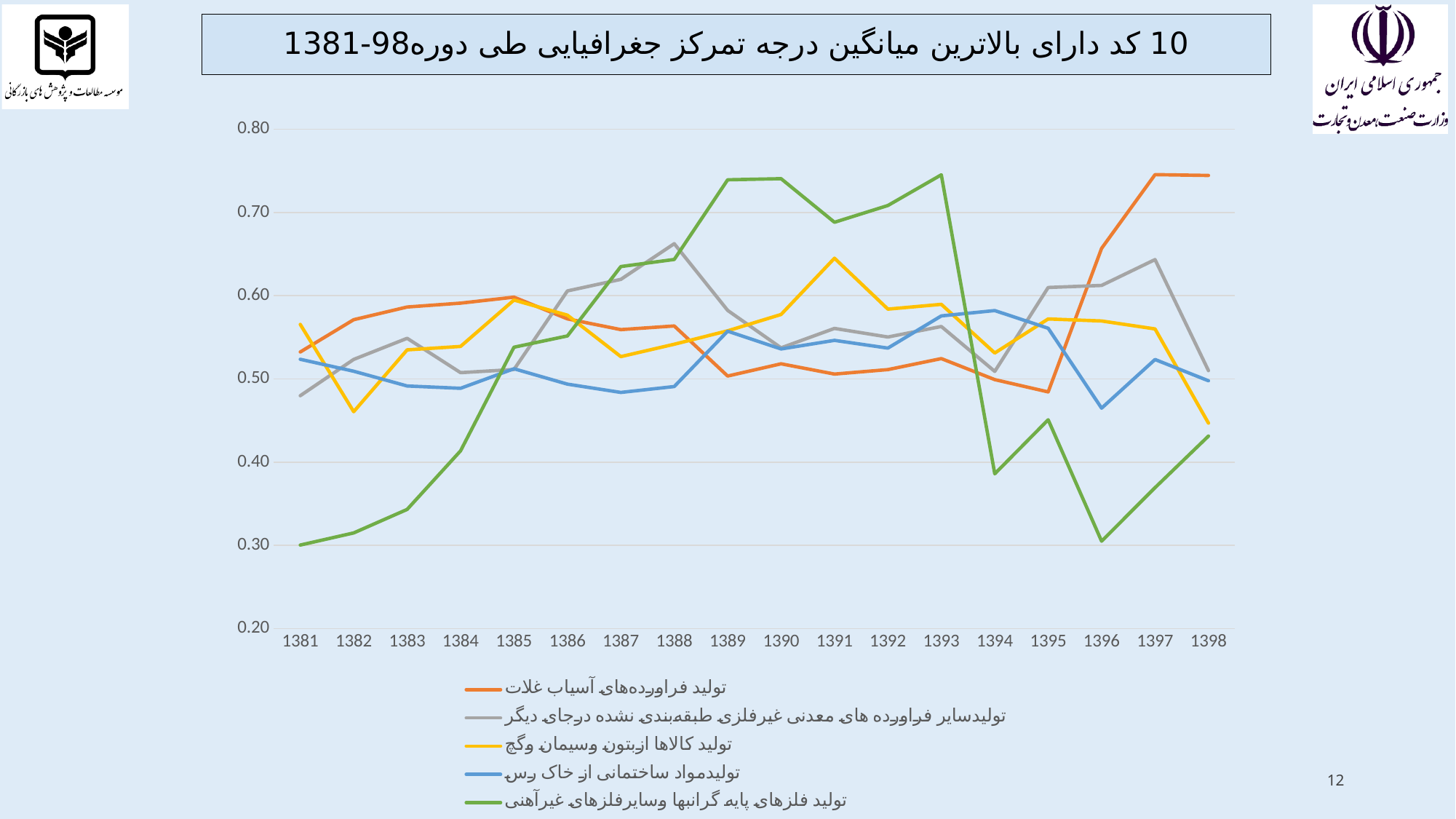
Is the value for تولید فلزهای پایه گرانبها وسایرفلزهای غیرآهنی in 1394 greater or less than 0.40? less Does the value for تولید فلزهای پایه گرانبها وسایرفلزهای غیرآهنی rise or fall from 1381 to 1389? rise Is the value for تولید فلزهای پایه گرانبها وسایرفلزهای غیرآهنی in 1389 greater or less than 0.70? greater What is the title of the chart? 10 کد دارای بالاترین میانگین درجه تمرکز جغرافیایی طی دوره1381-98 Which series has the highest value in 1393? تولید فلزهای پایه گرانبها وسایرفلزهای غیرآهنی Is the value for تولیدمواد ساختمانی از خاک رس in 1396 greater or less than 0.50? less How many years are shown along the x axis? 18 How many series does the legend list? 5 Which series has the lowest value in 1381? تولید فلزهای پایه گرانبها وسایرفلزهای غیرآهنی What kind of chart is shown on the slide? line chart Which series has the highest value in 1398? تولید فراورده‌های آسیاب غلات In 1389, which is larger: the value for تولید فلزهای پایه گرانبها وسایرفلزهای غیرآهنی or the value for تولید فراورده‌های آسیاب غلات? تولید فلزهای پایه گرانبها وسایرفلزهای غیرآهنی